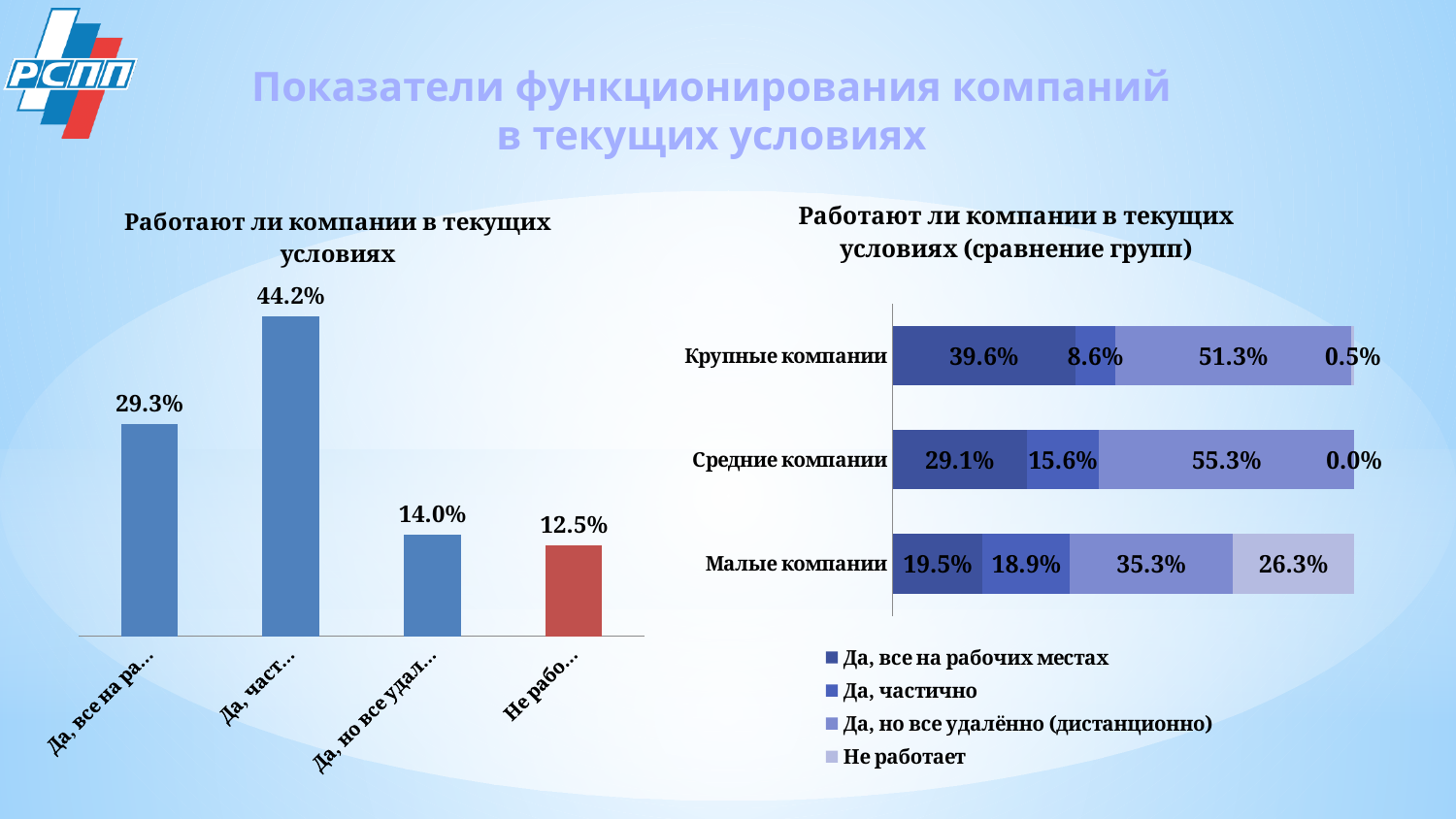
In the left chart "Работают ли компании в текущих условиях", what is the value of the tallest bar? 44.2% In the left chart "Работают ли компании в текущих условиях", what is the value of the first bar (labelled "Да, все на ра...")? 29.3% In the right chart "Работают ли компании в текущих условиях (сравнение групп)", what is the value for "Да, все на рабочих местах" for Крупные компании? 39.6% In the right chart "Работают ли компании в текущих условиях (сравнение групп)", what is the value for "Не работает" for Малые компании? 26.3% In the left chart "Работают ли компании в текущих условиях", which bar is lowest? The red bar labelled "Не рабо..." (12.5%) In the right chart "Работают ли компании в текущих условиях (сравнение групп)", which group has the highest share for "Да, но все удалённо (дистанционно)"? Средние компании In the left chart "Работают ли компании в текущих условиях", how many bars are plotted? 4 In the right chart "Работают ли компании в текущих условиях (сравнение групп)", how many series does the legend list? 4 In the left chart "Работают ли компании в текущих условиях", what is the value of the red bar (the last one, labelled "Не рабо...")? 12.5% In the right chart "Работают ли компании в текущих условиях (сравнение групп)", what is the value for "Да, частично" for Средние компании? 15.6% What type of chart is the right chart "Работают ли компании в текущих условиях (сравнение групп)"? Stacked horizontal bar chart In the left chart "Работают ли компании в текущих условиях", what is the difference between the second bar (44.2%) and the first bar (29.3%)? 14.9%